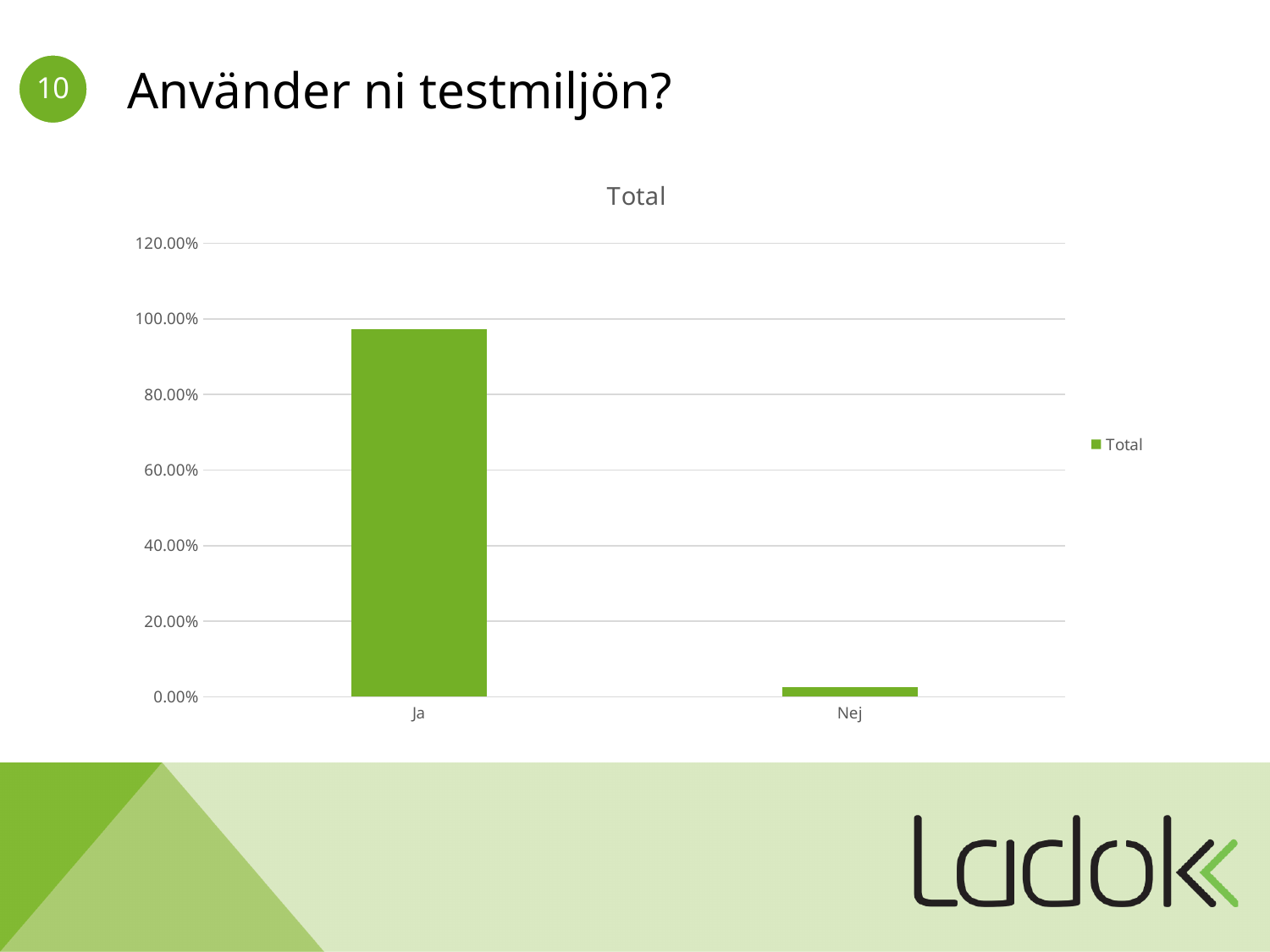
How many categories are shown on the x axis of the chart? 2 How many series does the legend list? 1 What is the name of the series shown in the legend? Total Is the value for Ja greater or less than 100.00%? less Which category has the highest value? Ja What is the highest value shown on the y axis? 120.00% Which category has the lowest value? Nej Is the value for Nej greater or less than 20.00%? less What type of chart is shown on the slide? bar chart Which is larger, the value for Ja or the value for Nej? Ja Is the value for Ja greater or less than 80.00%? greater What is the title of the chart? Total